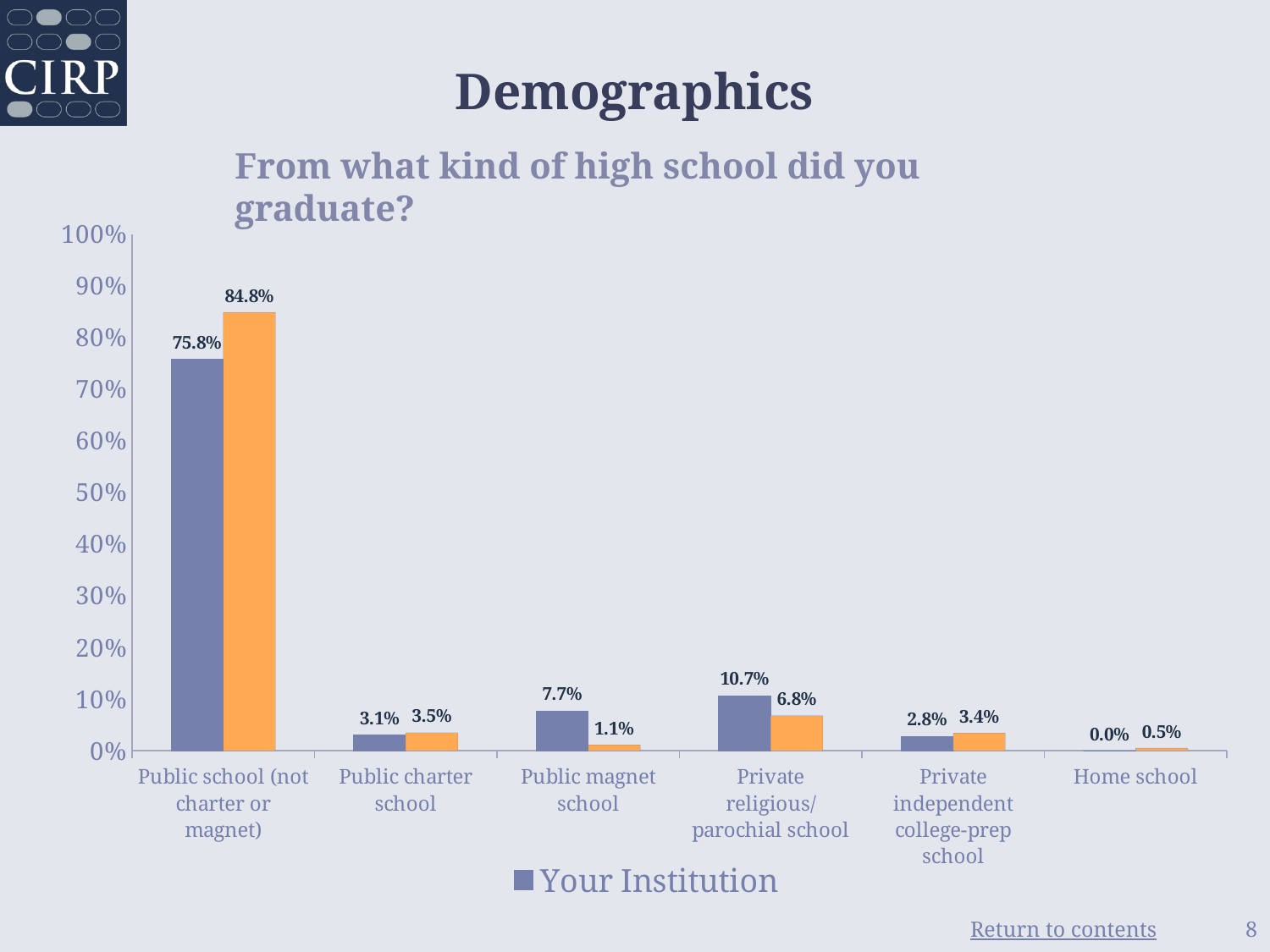
How many high school categories are shown on the x axis? 6 What is the difference between the orange bar and the Your Institution bar for Public school (not charter or magnet)? 9.0% What question is the chart titled with? From what kind of high school did you graduate? For Public magnet school, which is larger: the Your Institution bar or the orange bar? Your Institution Which category has the lowest Your Institution value? Home school What kind of chart is shown on the slide? Bar chart Which category has the highest Your Institution value? Public school (not charter or magnet) What is the Your Institution value for Private religious/parochial school? 10.7% What is the Your Institution value for Public school (not charter or magnet)? 75.8% What is the value of the orange bar for Public school (not charter or magnet)? 84.8% What is the value of the orange bar for Public magnet school? 1.1% Is the Your Institution value for Public school (not charter or magnet) greater or less than 70%? greater